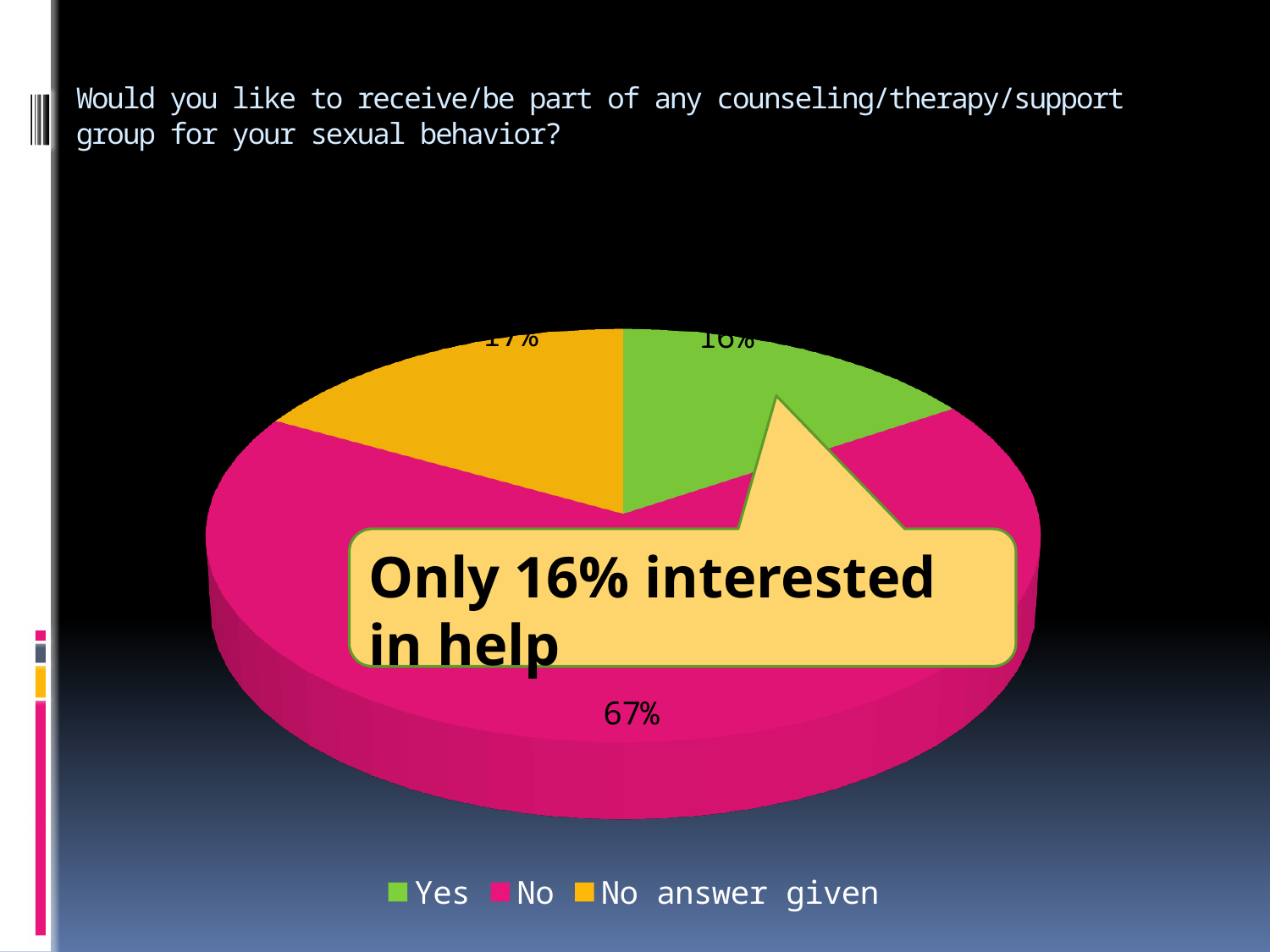
How many slices does the pie chart have? 3 Which is larger, the share for "No" or the share for "Yes"? No Which response has the largest share of the pie? No What percentage of respondents answered "No"? 67% What colour is the "No" slice of the pie? pink What kind of chart is shown on the slide? pie chart What is the difference in percentage points between the "No" share and the "Yes" share? 51% What does the callout box on the chart say? Only 16% interested in help Is the share for "Yes" greater or less than 25%? less How many entries does the legend list? 3 Is the share for "No" greater or less than 50%? greater What percentage of respondents answered "Yes"? 16%